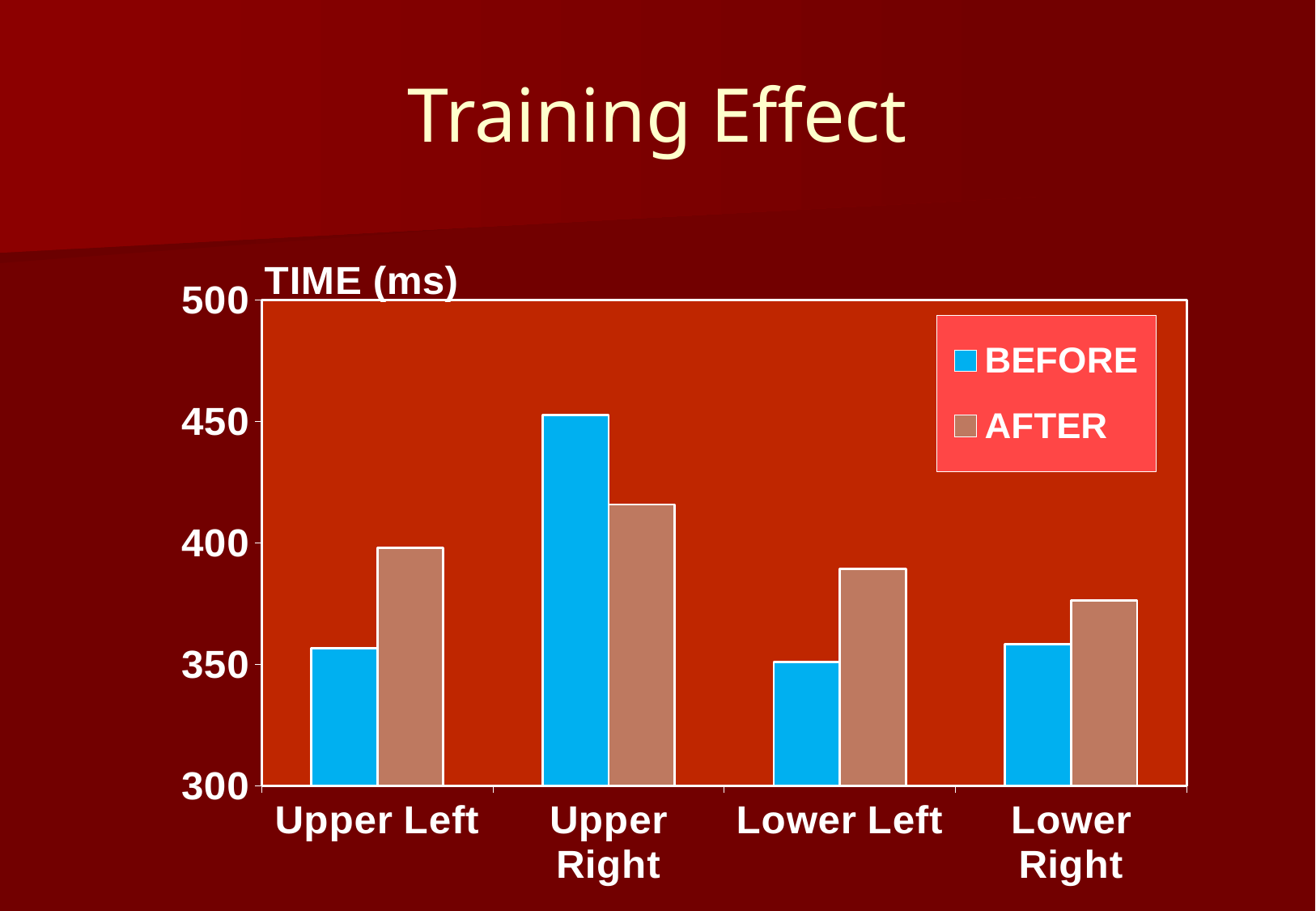
For Upper Right, which is larger, the BEFORE value or the AFTER value? BEFORE How many categories are shown on the x axis? 4 How many series does the legend list? 2 Which category has the lowest AFTER value? Lower Right For Upper Left, which is larger, the BEFORE value or the AFTER value? AFTER What is the label on the vertical axis of the chart? TIME (ms) Which category has the highest AFTER value? Upper Right What kind of chart is shown on the slide? bar chart Is the BEFORE value for Upper Right greater or less than 400? greater Which series is shown in blue in the legend? BEFORE Which category has the highest BEFORE value? Upper Right Is the AFTER value for Lower Left greater or less than 400? less